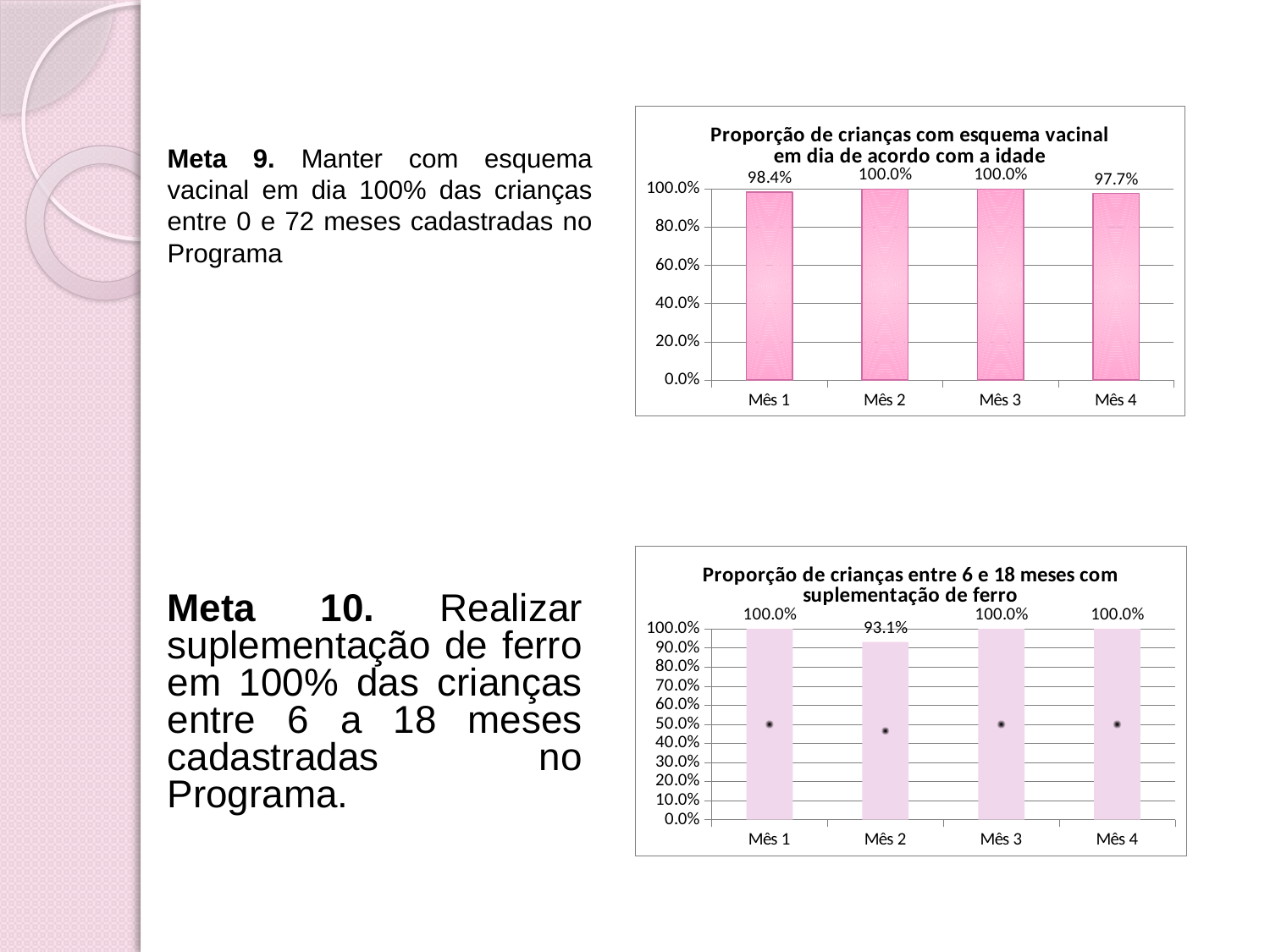
In the top chart (Proporção de crianças com esquema vacinal em dia de acordo com a idade), what is the value for Mês 1? 98.4% In the top chart (Proporção de crianças com esquema vacinal em dia de acordo com a idade), is the value for Mês 1 greater or less than 80.0%? greater In the bottom chart (Proporção de crianças entre 6 e 18 meses com suplementação de ferro), is the value for Mês 1 larger or smaller than the value for Mês 2? Larger In the top chart (Proporção de crianças com esquema vacinal em dia de acordo com a idade), what is the value for Mês 4? 97.7% In the bottom chart (Proporção de crianças entre 6 e 18 meses com suplementação de ferro), what is the value for Mês 2? 93.1% In the top chart (Proporção de crianças com esquema vacinal em dia de acordo com a idade), which month has the lowest value? Mês 4 In the top chart (Proporção de crianças com esquema vacinal em dia de acordo com a idade), how many months are shown on the x axis? 4 In the top chart (Proporção de crianças com esquema vacinal em dia de acordo com a idade), what kind of chart is it? Bar chart In the bottom chart (Proporção de crianças entre 6 e 18 meses com suplementação de ferro), what is the value for Mês 3? 100.0% In the top chart (Proporção de crianças com esquema vacinal em dia de acordo com a idade), what is the difference between the values for Mês 2 and Mês 4? 2.3% In the bottom chart (Proporção de crianças entre 6 e 18 meses com suplementação de ferro), which month has the lowest value? Mês 2 In the bottom chart (Proporção de crianças entre 6 e 18 meses com suplementação de ferro), what is the difference between the values for Mês 1 and Mês 2? 6.9%